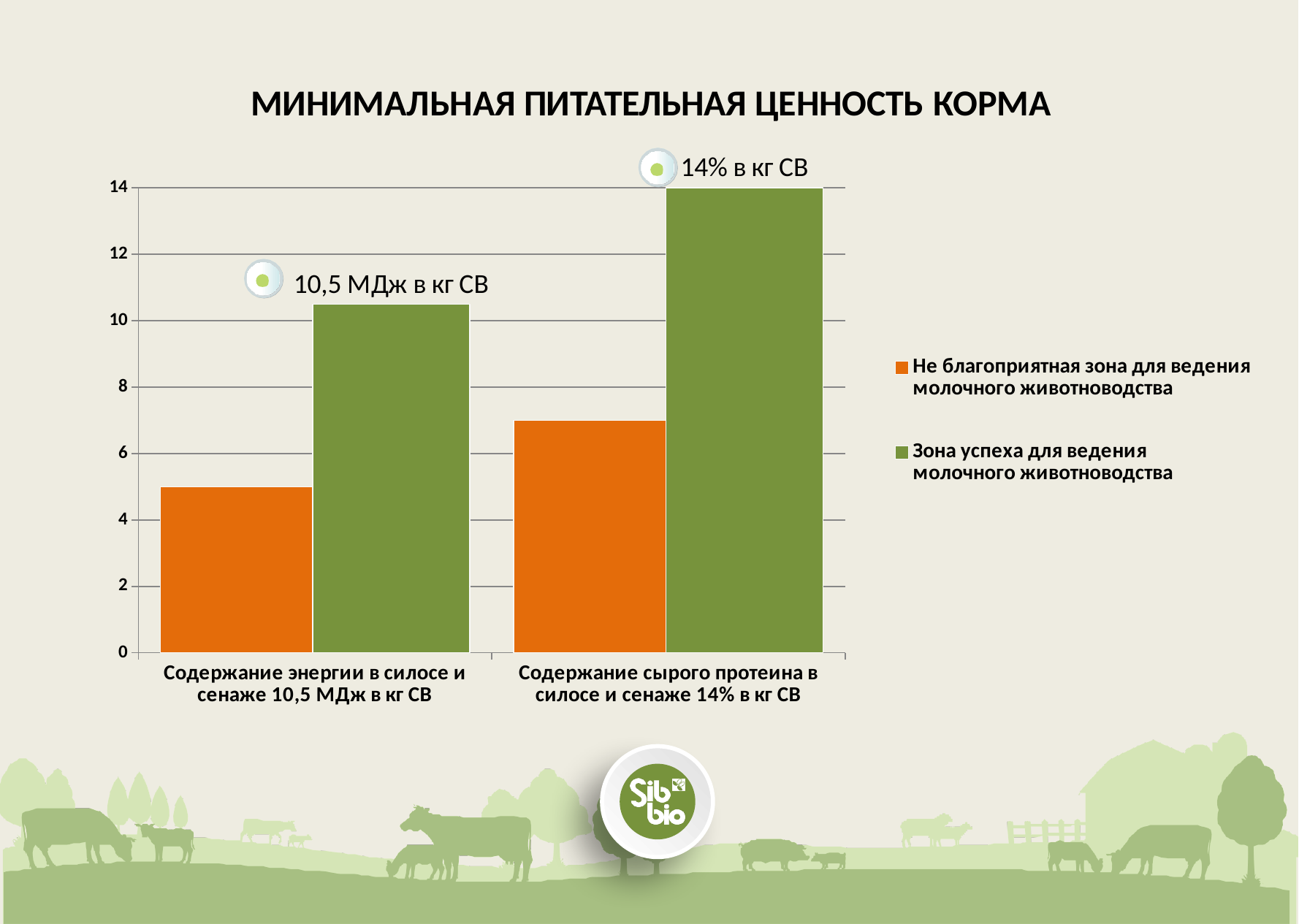
In the category 'Содержание энергии в силосе и сенаже', which series has the larger value: 'Не благоприятная зона' or 'Зона успеха'? Зона успеха для ведения молочного животноводства How many categories are shown on the x axis? 2 How many series does the legend list? 2 What value is labelled for the green bar (Зона успеха) in the category 'Содержание энергии в силосе и сенаже'? 10,5 МДж в кг СВ Is the value of the orange bar (Не благоприятная зона) in the category 'Содержание сырого протеина в силосе и сенаже' greater or less than 6? greater Is the value of the orange bar (Не благоприятная зона) in the category 'Содержание энергии в силосе и сенаже' greater or less than 6? less What kind of chart is shown on the slide? bar chart What is the title of the chart? МИНИМАЛЬНАЯ ПИТАТЕЛЬНАЯ ЦЕННОСТЬ КОРМА Which colour represents 'Не благоприятная зона для ведения молочного животноводства' in the legend? orange Is the value of the orange bar (Не благоприятная зона) in the category 'Содержание сырого протеина в силосе и сенаже' greater or less than 8? less Which bar is the tallest in the chart? Зона успеха in 'Содержание сырого протеина в силосе и сенаже' (14%) What value is labelled for the green bar (Зона успеха) in the category 'Содержание сырого протеина в силосе и сенаже'? 14% в кг СВ